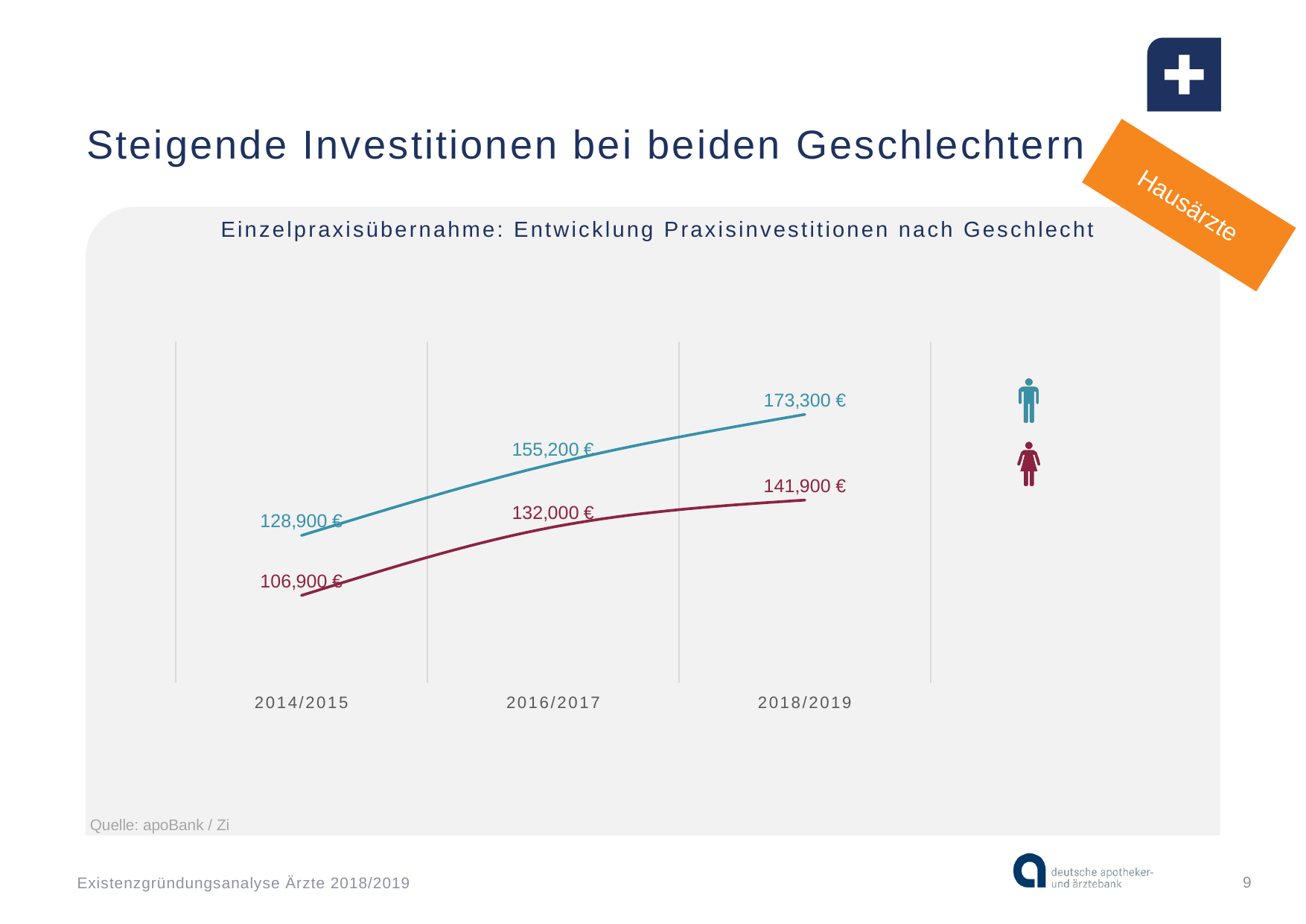
What is the value of the blue (male) line for 2016/2017? 155,200 € Do the values of both lines rise or fall from 2014/2015 to 2018/2019? rise What type of chart is shown on the slide? line chart In which period does the red (female) line have its lowest value? 2014/2015 By how much did the red (female) value increase from 2014/2015 to 2016/2017? 25,100 € Which is larger in 2016/2017, the blue (male) value or the red (female) value? blue (male), 155,200 € How many periods are shown on the x axis? 3 What is the value of the blue (male) line for 2018/2019? 173,300 € What is the value of the red (female) line for 2018/2019? 141,900 € In which period does the blue (male) line reach its highest value? 2018/2019 What is the value of the red (female) line for 2014/2015? 106,900 € What is the difference between the blue (male) and red (female) values in 2018/2019? 31,400 €